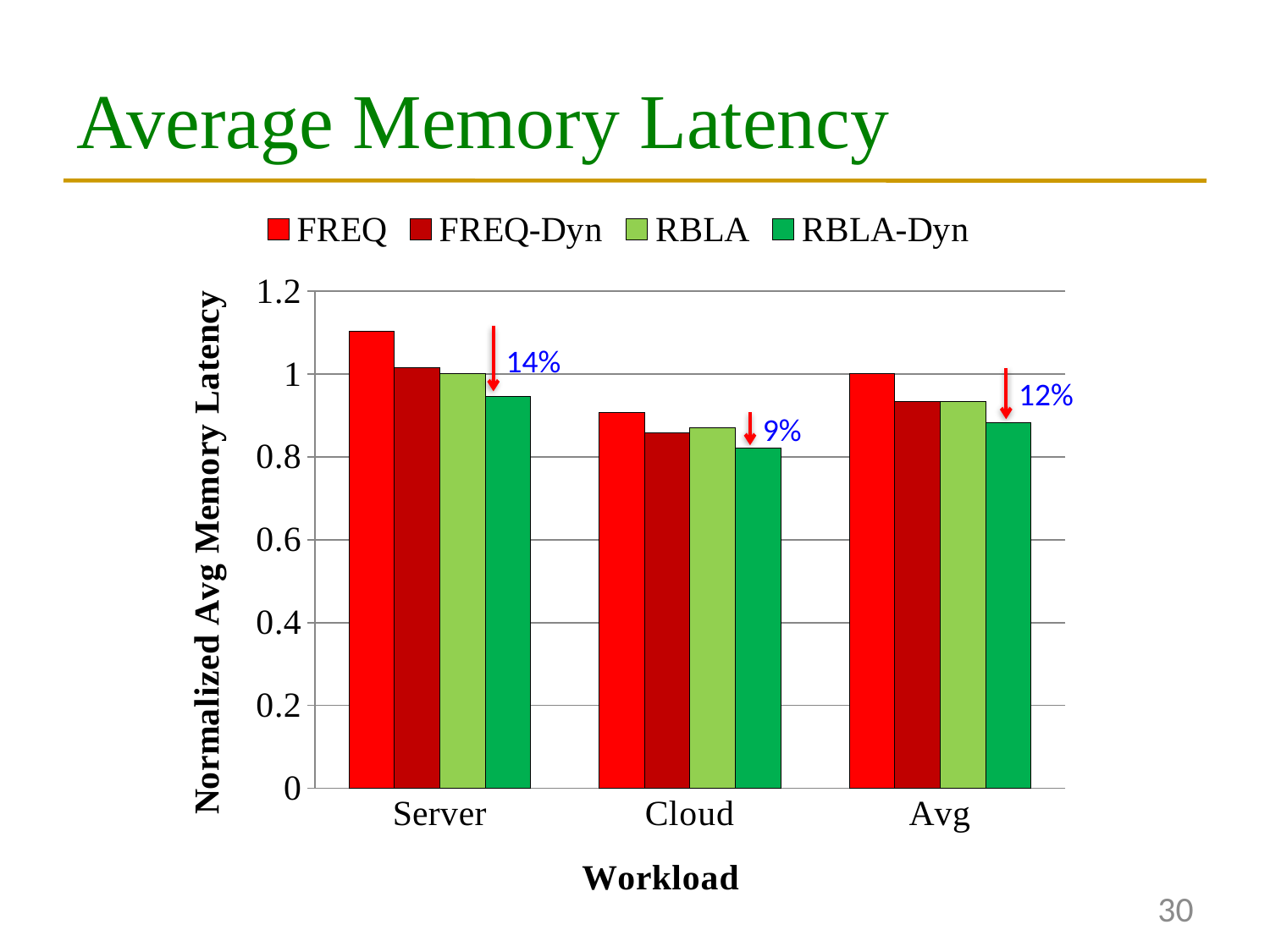
How many workload categories are shown on the x axis? 3 What kind of chart is shown on the slide? bar chart Which series has the lowest bar for the Server workload? RBLA-Dyn Which is larger, the FREQ value for Server or the FREQ value for Cloud? Server Is the FREQ value for Cloud greater or less than 1? less What is the label of the y axis? Normalized Avg Memory Latency Is the FREQ value for Server greater or less than 1? greater How many series does the legend list? 4 Which series has the highest bar for the Server workload? FREQ What percentage reduction is annotated above the RBLA-Dyn bar for the Server workload? 14% Which series has the lowest bar for the Cloud workload? RBLA-Dyn Is the RBLA-Dyn value for Cloud greater or less than 1? less